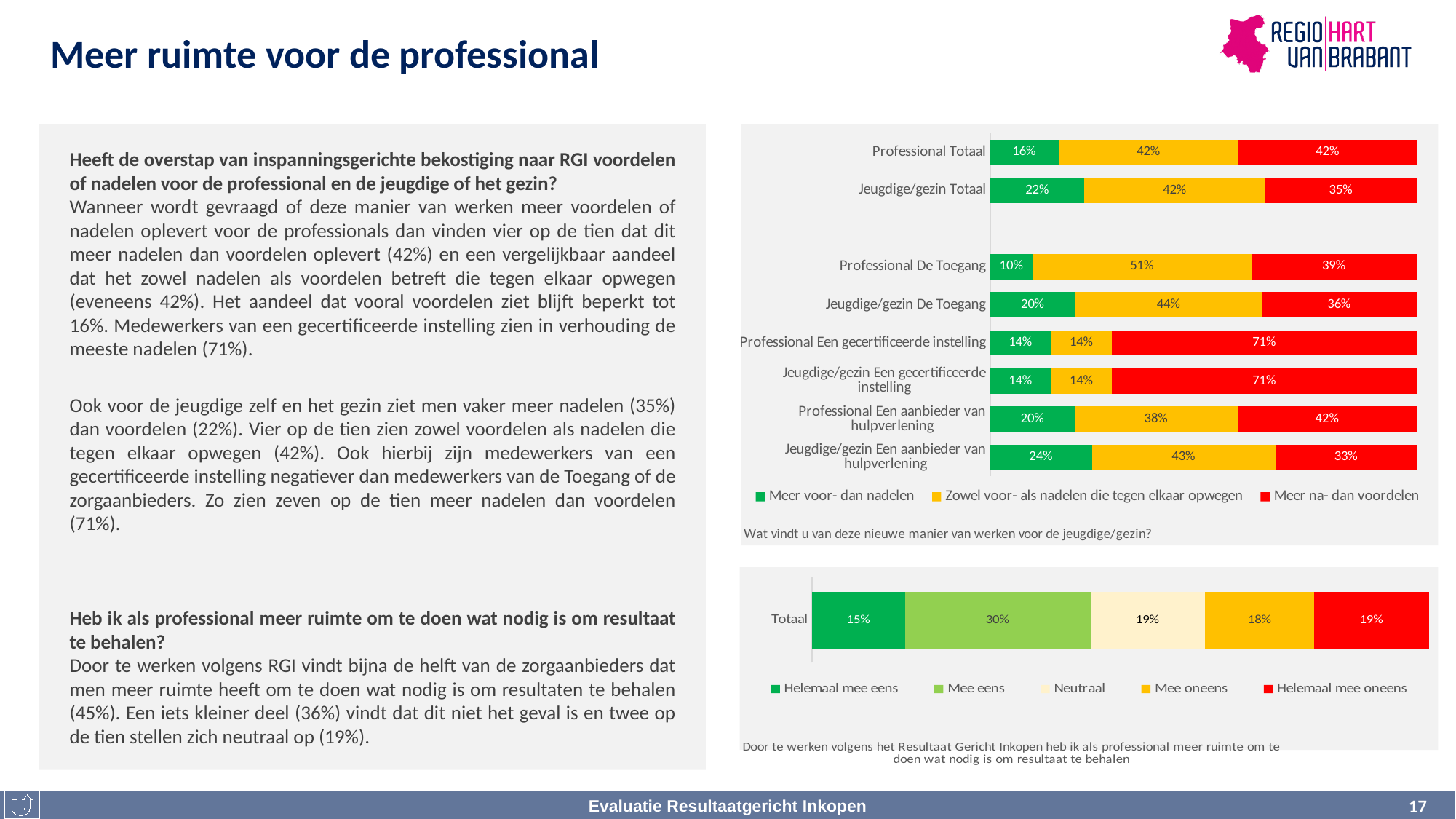
How many categories are shown in the top chart? 8 In the bottom chart, what is the combined value of 'Helemaal mee eens' and 'Mee eens' for Totaal? 45% How many series does the legend of the top chart list? 3 In the top chart, which is larger: the 'Meer voor- dan nadelen' value for Jeugdige/gezin Een aanbieder van hulpverlening or for Professional Een aanbieder van hulpverlening? Jeugdige/gezin Een aanbieder van hulpverlening In the top chart, what is the difference between the 'Meer na- dan voordelen' values for Professional Totaal and Jeugdige/gezin Totaal? 7 percentage points In the top chart, what is the 'Meer na- dan voordelen' value for Professional Totaal? 42% In the top chart, what is the 'Zowel voor- als nadelen die tegen elkaar opwegen' value for Professional De Toegang? 51% In the top chart, which category has the highest 'Meer na- dan voordelen' value? Professional Een gecertificeerde instelling and Jeugdige/gezin Een gecertificeerde instelling (71%) In the top chart, what is the 'Meer voor- dan nadelen' value for Jeugdige/gezin Totaal? 22% In the top chart, which category has the lowest 'Meer voor- dan nadelen' value? Professional De Toegang In the bottom chart, what is the 'Mee eens' value for Totaal? 30% What kind of chart is the bottom chart? Stacked bar chart